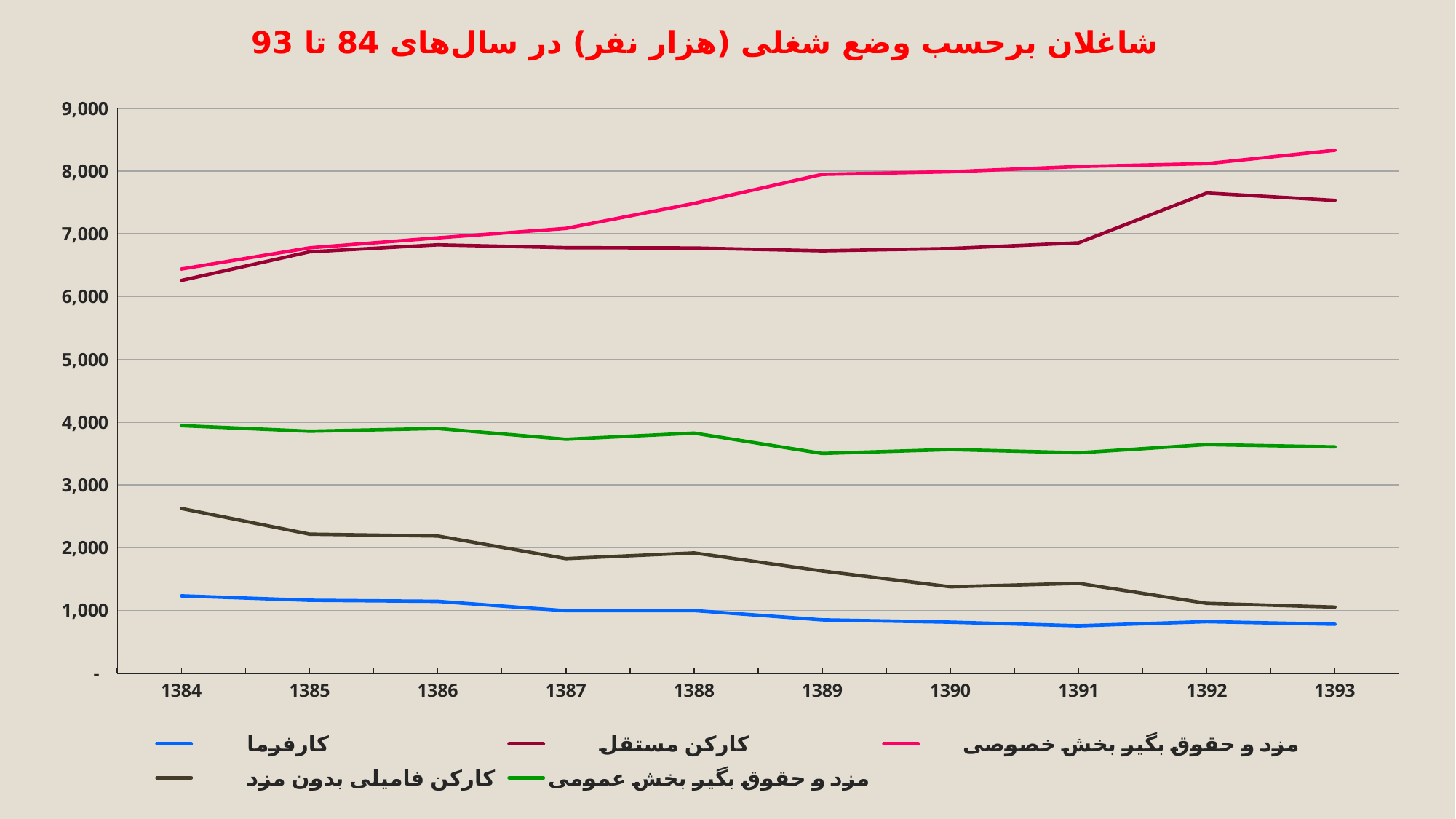
Is the value for کارفرما in 1391 greater or less than 1,000? less Is the value for مزد و حقوق بگیر بخش عمومی in 1389 greater or less than 4,000? less Is the value for کارکن فامیلی بدون مزد in 1384 greater or less than 2,000? greater How many years are plotted along the x axis? 10 What kind of chart is shown on the slide? line chart Does the کارکن فامیلی بدون مزد series generally rise or fall from 1384 to 1393? fall Which series has the lowest value in 1393? کارفرما Which is larger in 1392: کارکن مستقل or مزد و حقوق بگیر بخش خصوصی? مزد و حقوق بگیر بخش خصوصی What colour is the line for مزد و حقوق بگیر بخش عمومی? green Which series has the highest value in 1393? مزد و حقوق بگیر بخش خصوصی How many series does the legend list? 5